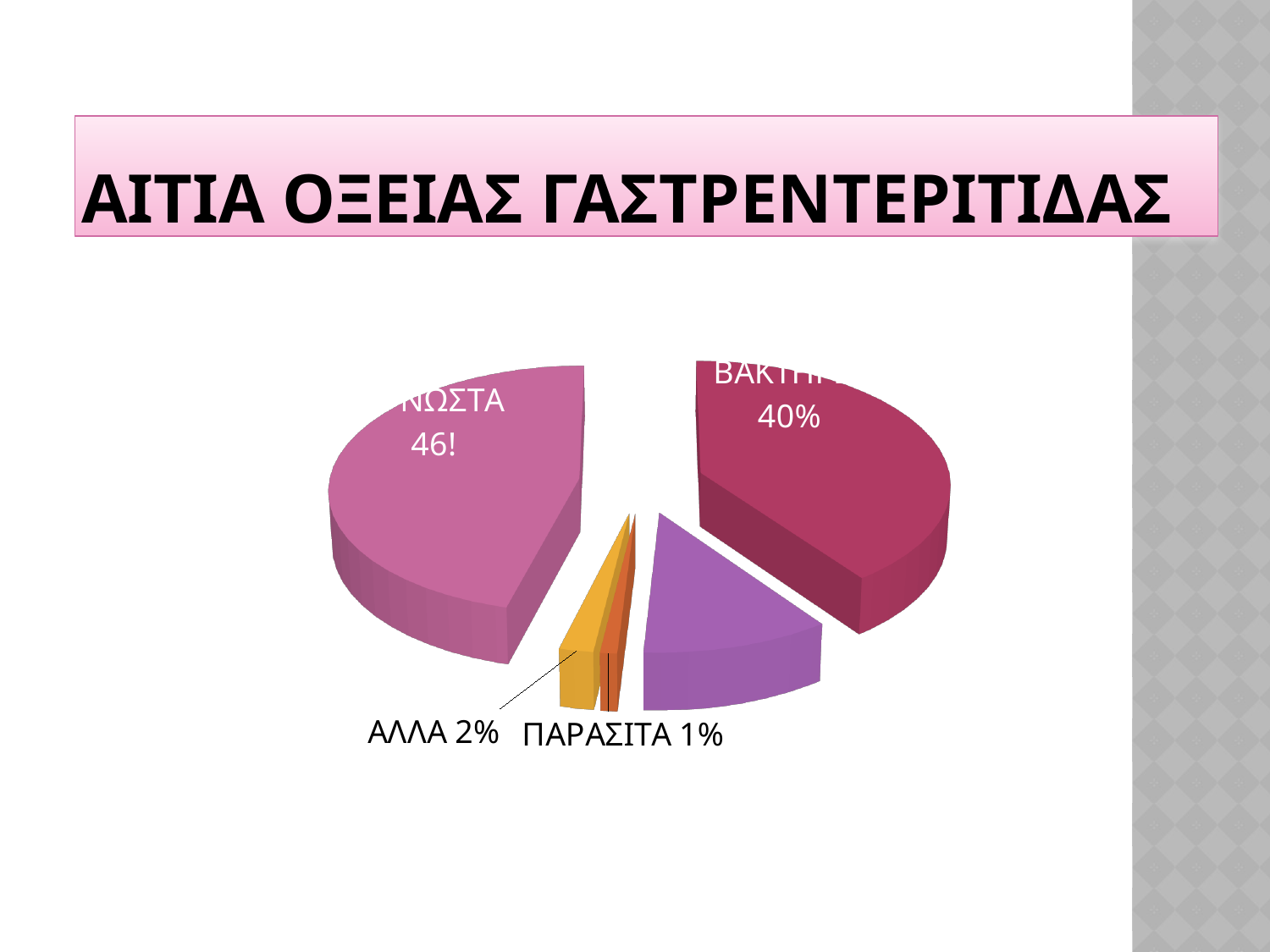
What is the title of the slide? ΑΙΤΙΑ ΟΞΕΙΑΣ ΓΑΣΤΡΕΝΤΕΡΙΤΙΔΑΣ What kind of chart is shown on the slide? pie chart What is the difference between the ΑΛΛΑ share and the ΠΑΡΑΣΙΤΑ share? 1% Which is larger, the ΑΛΛΑ slice or the ΠΑΡΑΣΙΤΑ slice? ΑΛΛΑ How many slices does the pie chart have? 5 What share of the pie is labelled ΠΑΡΑΣΙΤΑ? 1% What share of the pie is labelled ΑΛΛΑ? 2% What colour is the ΑΛΛΑ slice? orange Which labelled slice has the smallest share of the pie? ΠΑΡΑΣΙΤΑ